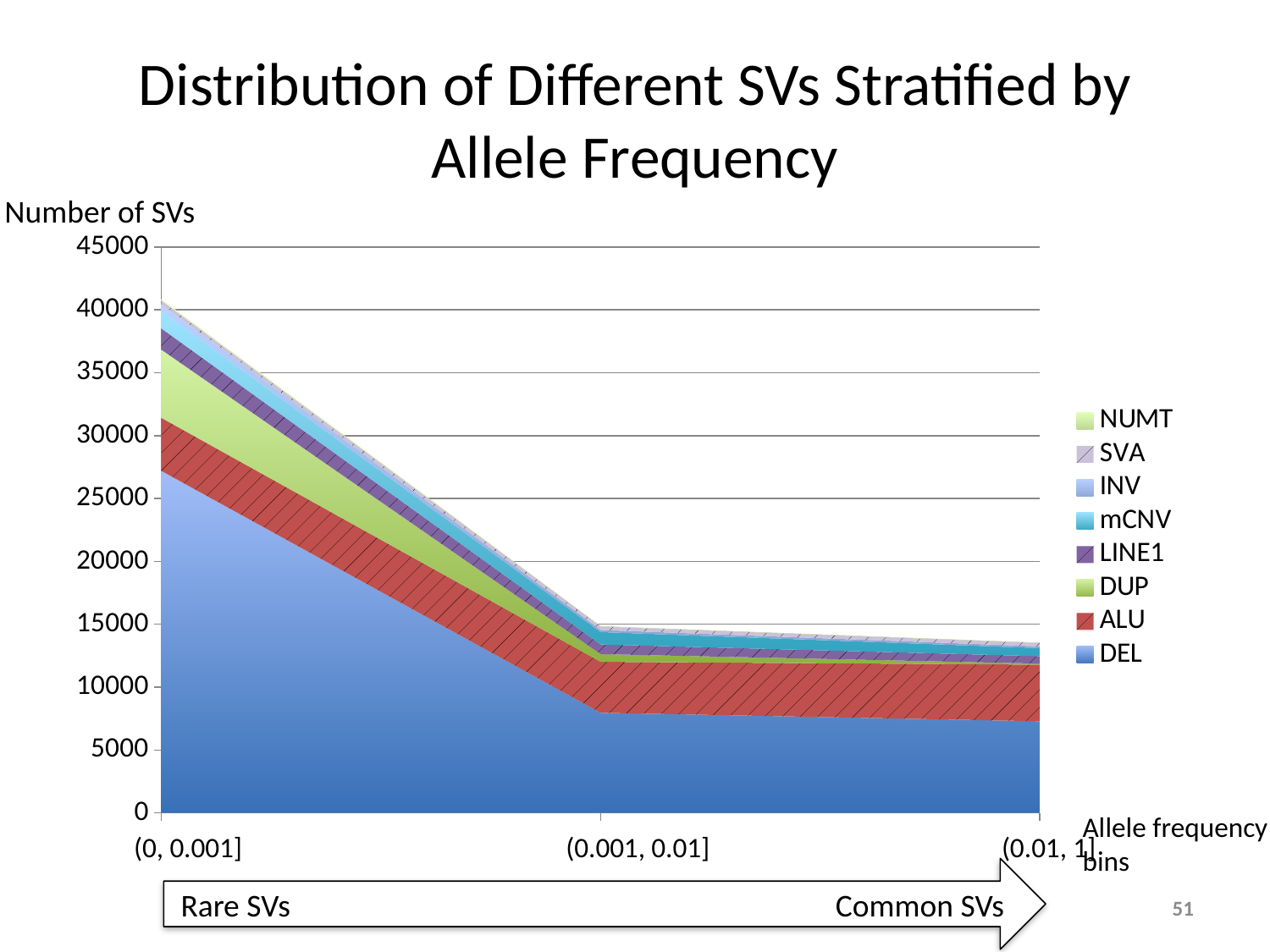
Is the value for DEL in the (0, 0.001] bin greater or less than 25000? greater Is the value for DEL in the (0.01, 1] bin greater or less than 10000? less Which allele frequency bin has the highest total number of SVs? (0, 0.001] Does the total number of SVs rise or fall from the (0, 0.001] bin to the (0.01, 1] bin? fall How many allele frequency bins are shown on the x axis? 3 Is the total number of SVs in the (0, 0.001] bin greater or less than 35000? greater Which series is listed at the bottom of the legend? DEL Which series contributes the most SVs in the (0, 0.001] bin? DEL What is the label of the vertical axis? Number of SVs What kind of chart is shown on the slide? stacked area chart How many series does the legend list? 8